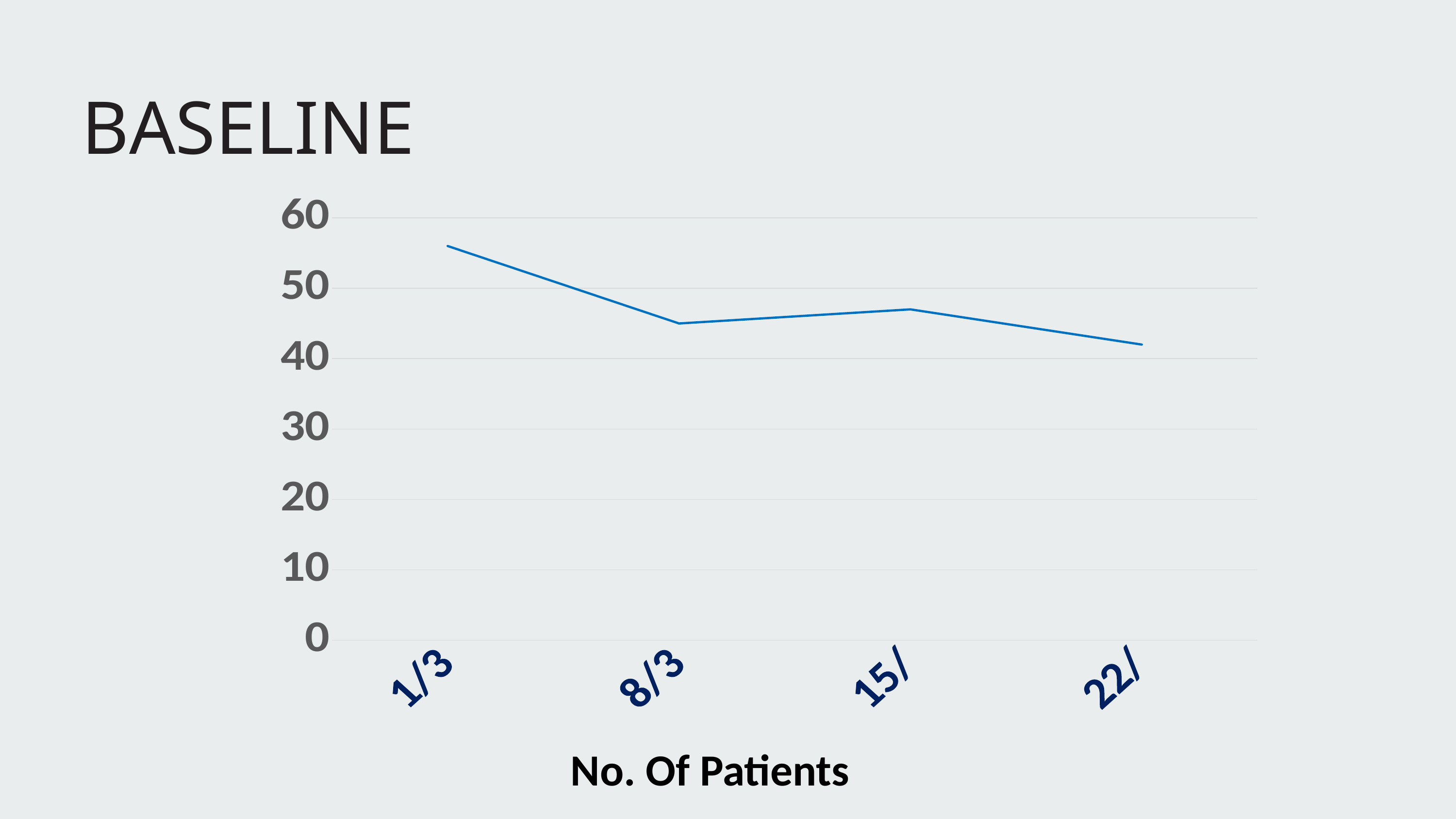
Which category has the lowest value? 22/ Is the value for 15/ greater or less than 50? less What is the title of the chart? BASELINE Which category has the highest value? 1/3 How many points are plotted on the line? 4 Is the value for 8/3 greater or less than 50? less Overall, do the values rise or fall from 1/3 to 22/? fall Is the value for 1/3 greater or less than 50? greater Which is larger, the value for 1/3 or the value for 22/? 1/3 What kind of chart is shown on the slide? line chart What is the label on the x axis of the chart? No. Of Patients